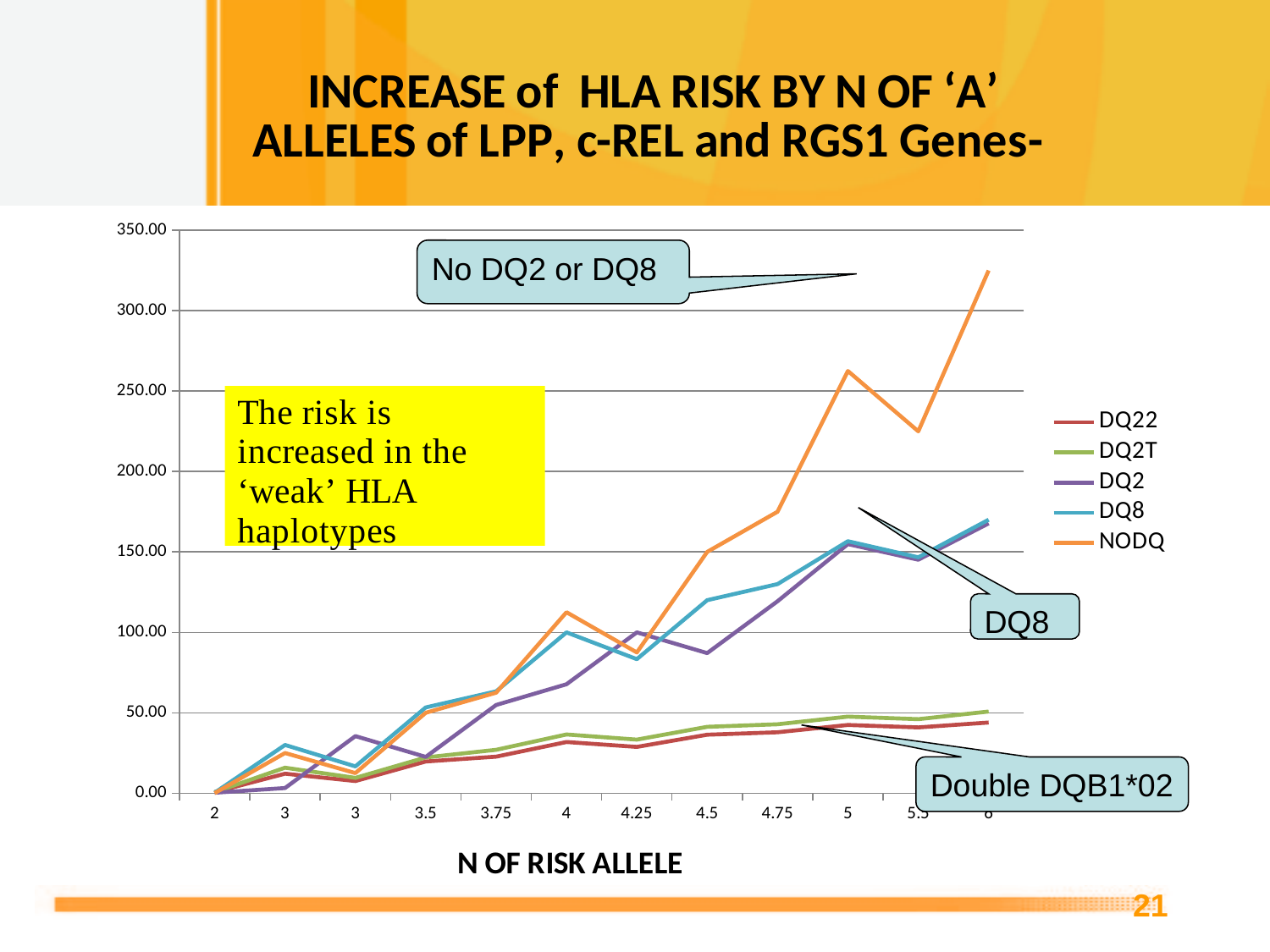
At x = 5, which is larger, NODQ or DQ2? NODQ How many points are plotted along the x axis for each series? 12 What kind of chart is shown on the slide? line chart Does the NODQ series generally rise or fall as the number of risk alleles increases? rise Is the value for DQ22 at x = 6 greater or less than 50? less Is the value for NODQ at x = 6 greater or less than 300? greater How many series does the legend list? 5 Is the value for NODQ at x = 5 greater or less than 250? greater Which series has the highest value at x = 6? NODQ What colour is the NODQ line in the legend? orange What is the title of the x axis? N OF RISK ALLELE